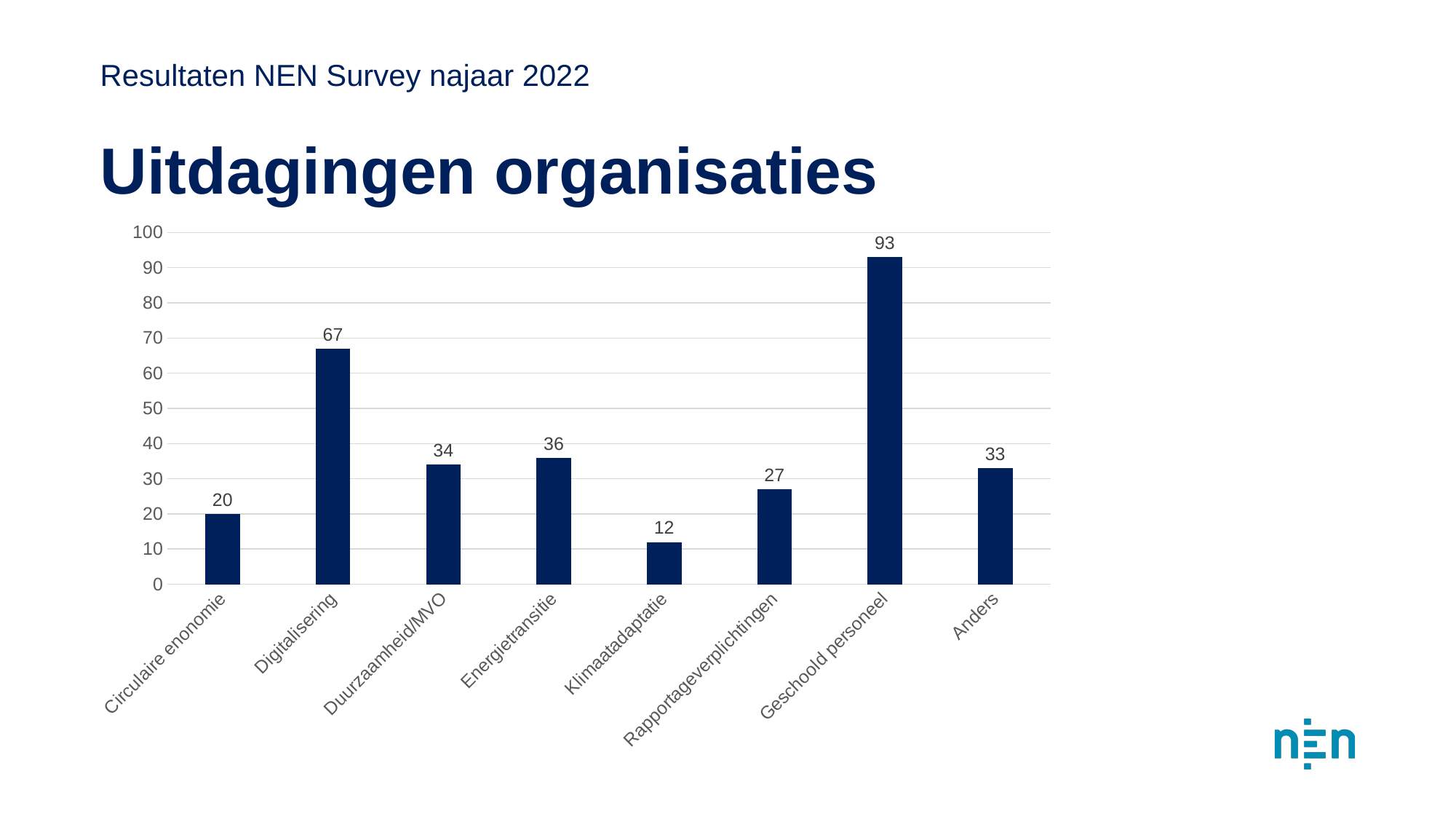
What is the value for Rapportageverplichtingen? 27 What is the value for Klimaatadaptatie? 12 What is the difference between the values for Geschoold personeel and Digitalisering? 26 How many categories are shown on the x axis? 8 Which category has the lowest value? Klimaatadaptatie Which category has the highest value? Geschoold personeel What is the value for Geschoold personeel? 93 Which is larger, the value for Anders or the value for Rapportageverplichtingen? Anders What is the value for Digitalisering? 67 What is the difference between the values for Energietransitie and Duurzaamheid/MVO? 2 What is the title of the slide above the chart? Uitdagingen organisaties What kind of chart is shown on the slide? Bar chart